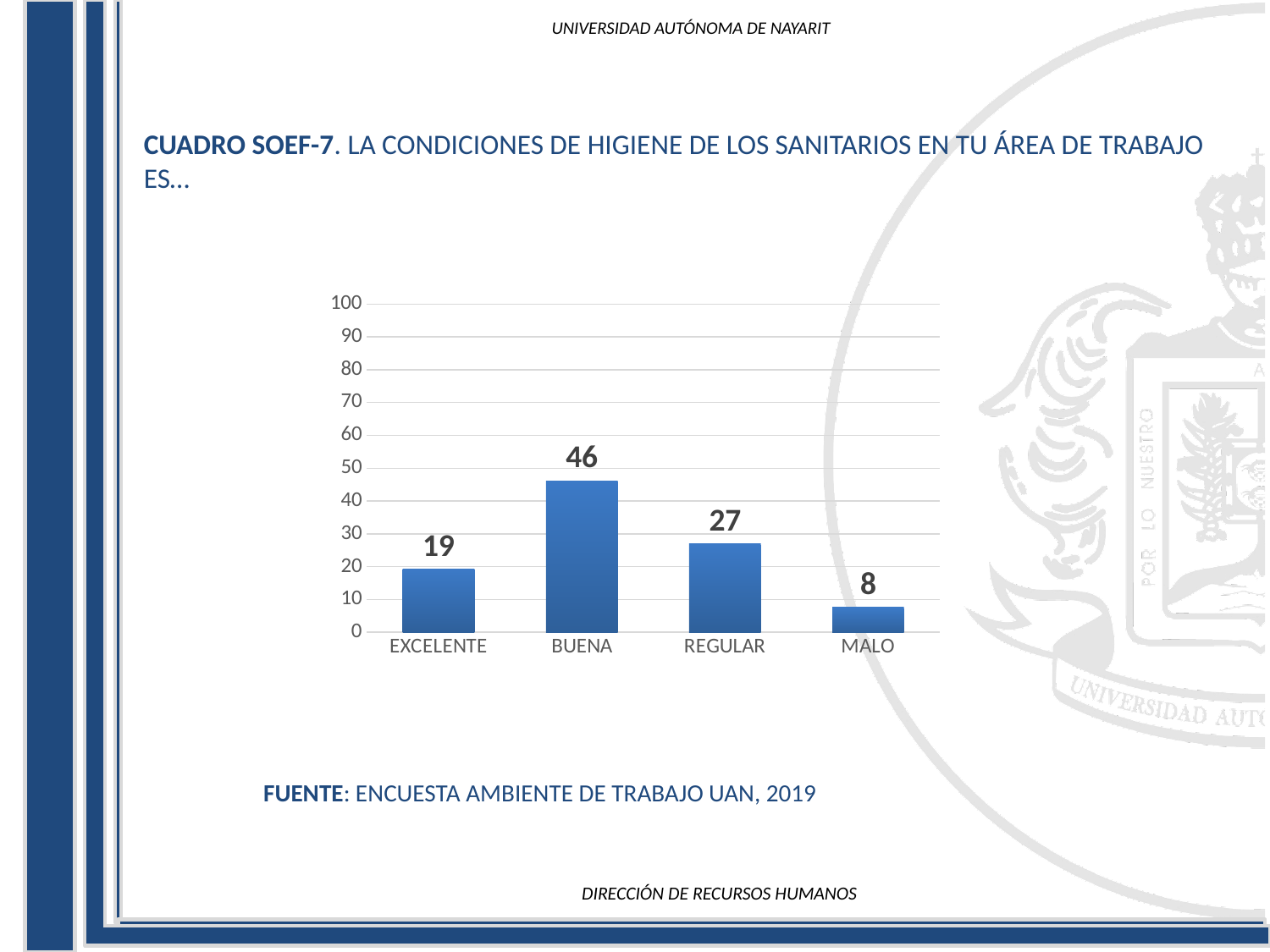
What kind of chart is shown on the slide? bar chart What is the value for BUENA? 46 Which category has the highest value? BUENA What is the value for EXCELENTE? 19 What is the maximum value shown on the vertical axis? 100 Which is larger, the value for EXCELENTE or the value for REGULAR? REGULAR Is the value for BUENA greater or less than 40? greater What is the value for MALO? 8 What is the source cited below the chart? ENCUESTA AMBIENTE DE TRABAJO UAN, 2019 What is the difference between the values for BUENA and REGULAR? 19 How many categories are shown on the x axis? 4 Which category has the lowest value? MALO